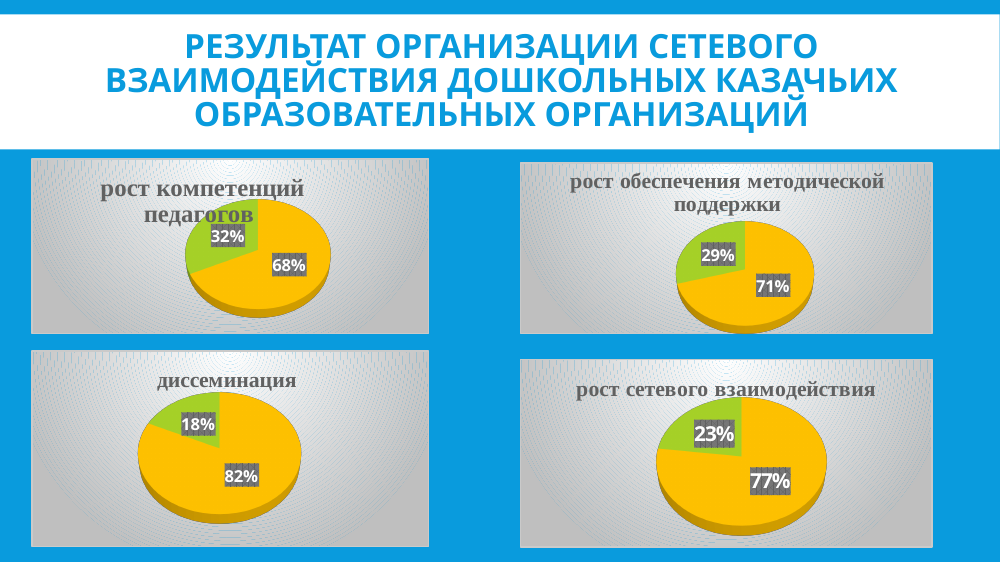
In the "диссеминация" chart, what share does the green slice show? 18% In the "рост компетенций педагогов" chart, what share does the green slice show? 32% In the "рост обеспечения методической поддержки" chart, what share does the orange slice show? 71% In the "рост сетевого взаимодействия" chart, what share does the orange slice show? 77% What kind of chart is used in the "рост компетенций педагогов" chart? pie chart In the "рост обеспечения методической поддержки" chart, what share does the green slice show? 29% How many pie charts are shown on the slide? 4 In the "рост компетенций педагогов" chart, what share does the orange slice show? 68% In the "диссеминация" chart, what share does the orange slice show? 82% In the "диссеминация" chart, what is the difference between the orange slice and the green slice? 64% How many slices does the "рост сетевого взаимодействия" pie chart have? 2 In the "рост сетевого взаимодействия" chart, what share does the green slice show? 23%